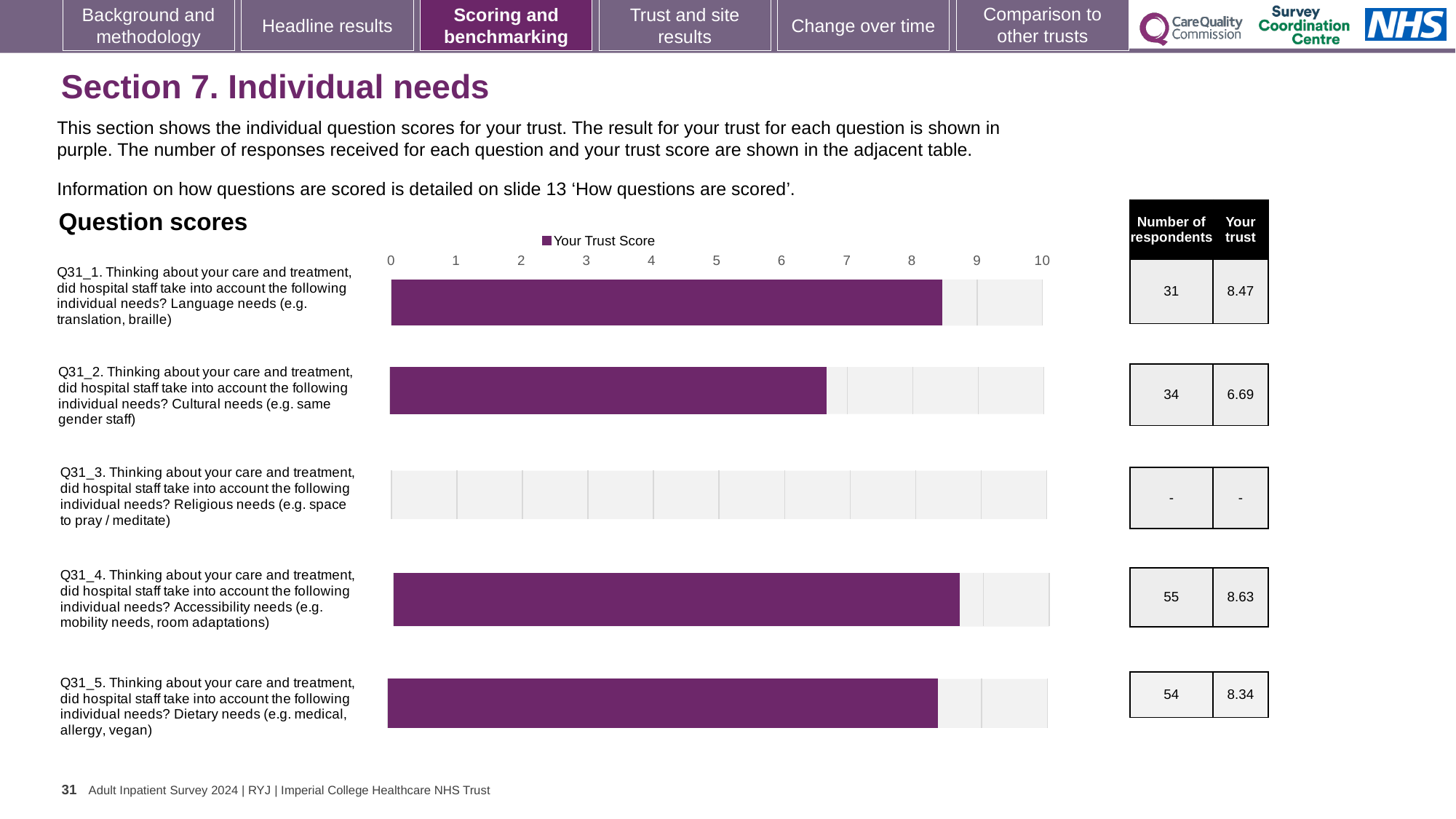
Which question has the highest trust score? Q31_4 (Accessibility needs) Which has the higher trust score, Q31_1 (Language needs) or Q31_5 (Dietary needs)? Q31_1 (Language needs) What is the trust score for Q31_2 (Cultural needs)? 6.69 What is the trust score for Q31_5 (Dietary needs)? 8.34 What is the trust score for Q31_4 (Accessibility needs)? 8.63 How many series does the chart legend list? 1 How many respondents answered Q31_4 (Accessibility needs)? 55 What is the difference between the trust scores for Q31_4 and Q31_2? 1.94 What is the trust score for Q31_1 (Language needs)? 8.47 Is the trust score for Q31_2 (Cultural needs) greater or less than 7? less Which question with a plotted bar has the lowest trust score? Q31_2 (Cultural needs) What kind of chart is used to show the question scores? Bar chart